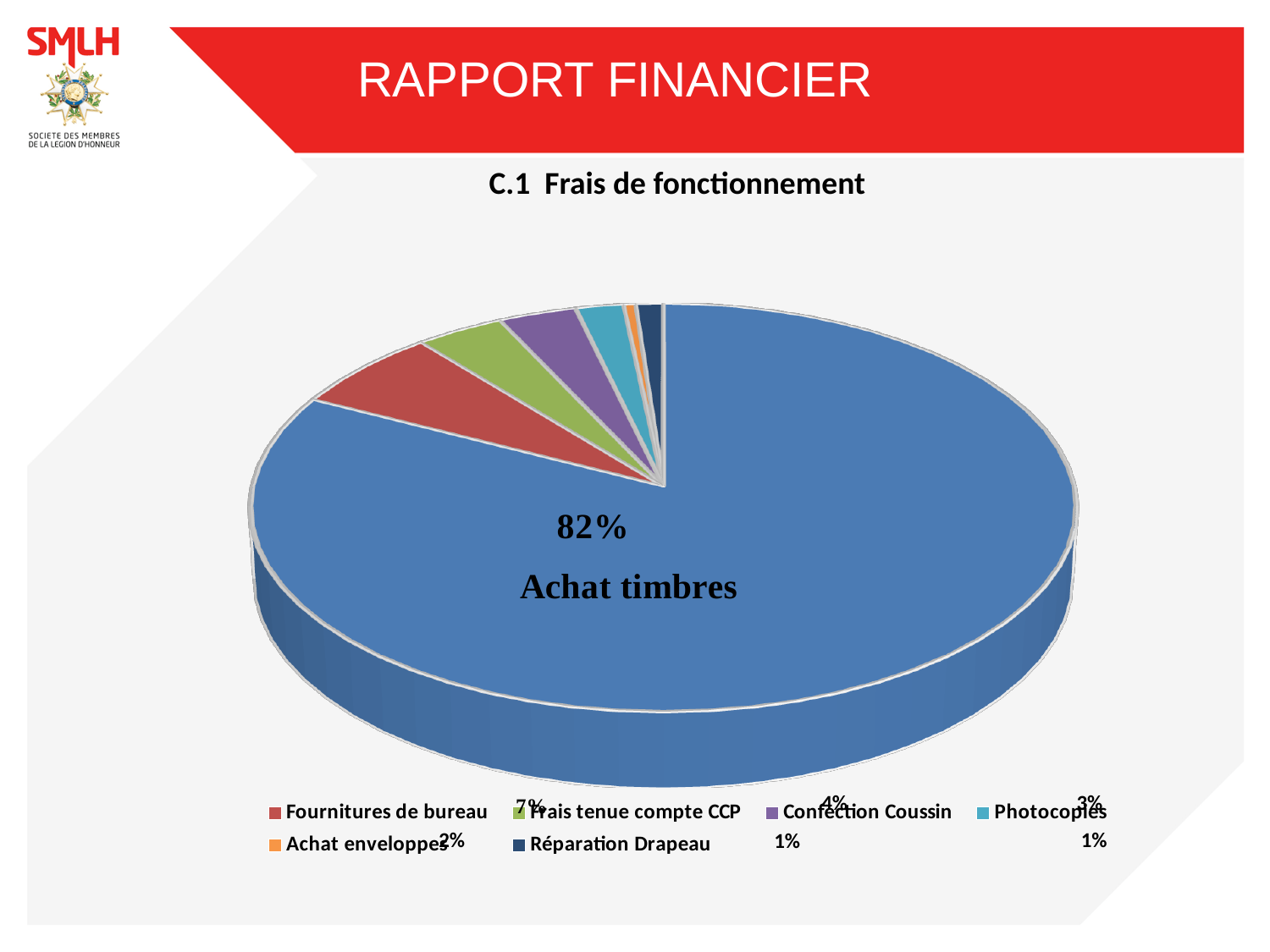
How many entries does the legend list? 6 Which category has the largest slice of the pie? Achat timbres How many slices does the pie chart have? 7 What colour is the slice for Achat timbres? Blue Which is larger, the slice for Fournitures de bureau or the slice for Frais tenue compte CCP? Fournitures de bureau What share of the pie does Achat timbres represent? 82% What type of chart is shown on the slide? Pie chart What is the title of the chart? C.1 Frais de fonctionnement Which is larger, the slice for Confection Coussin or the slice for Réparation Drapeau? Confection Coussin Which is larger, the slice for Achat timbres or the slice for Fournitures de bureau? Achat timbres